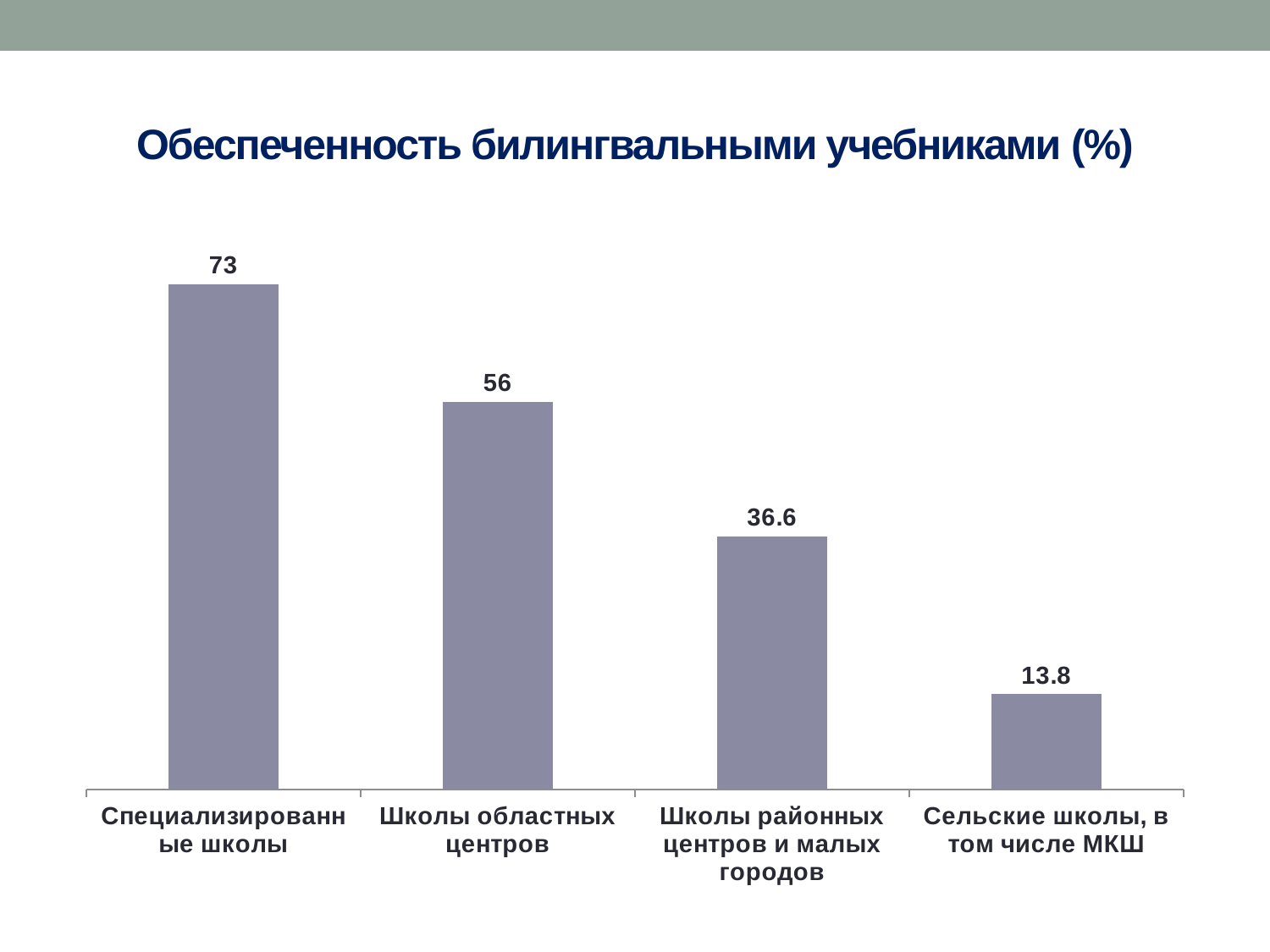
What is the difference between the values for Специализированные школы and Школы областных центров? 17 What is the value for Школы районных центров и малых городов? 36.6 Which is larger, the value for Школы областных центров or the value for Школы районных центров и малых городов? Школы областных центров What is the difference between the values for Школы районных центров и малых городов and Сельские школы, в том числе МКШ? 22.8 Which category has the lowest value? Сельские школы, в том числе МКШ Which category has the highest value? Специализированные школы What is the value for Специализированные школы? 73 What is the value for Сельские школы, в том числе МКШ? 13.8 Do the values rise or fall from left to right along the x axis? Fall What kind of chart is shown on the slide? Bar chart What is the value for Школы областных центров? 56 How many categories are shown in the chart? 4